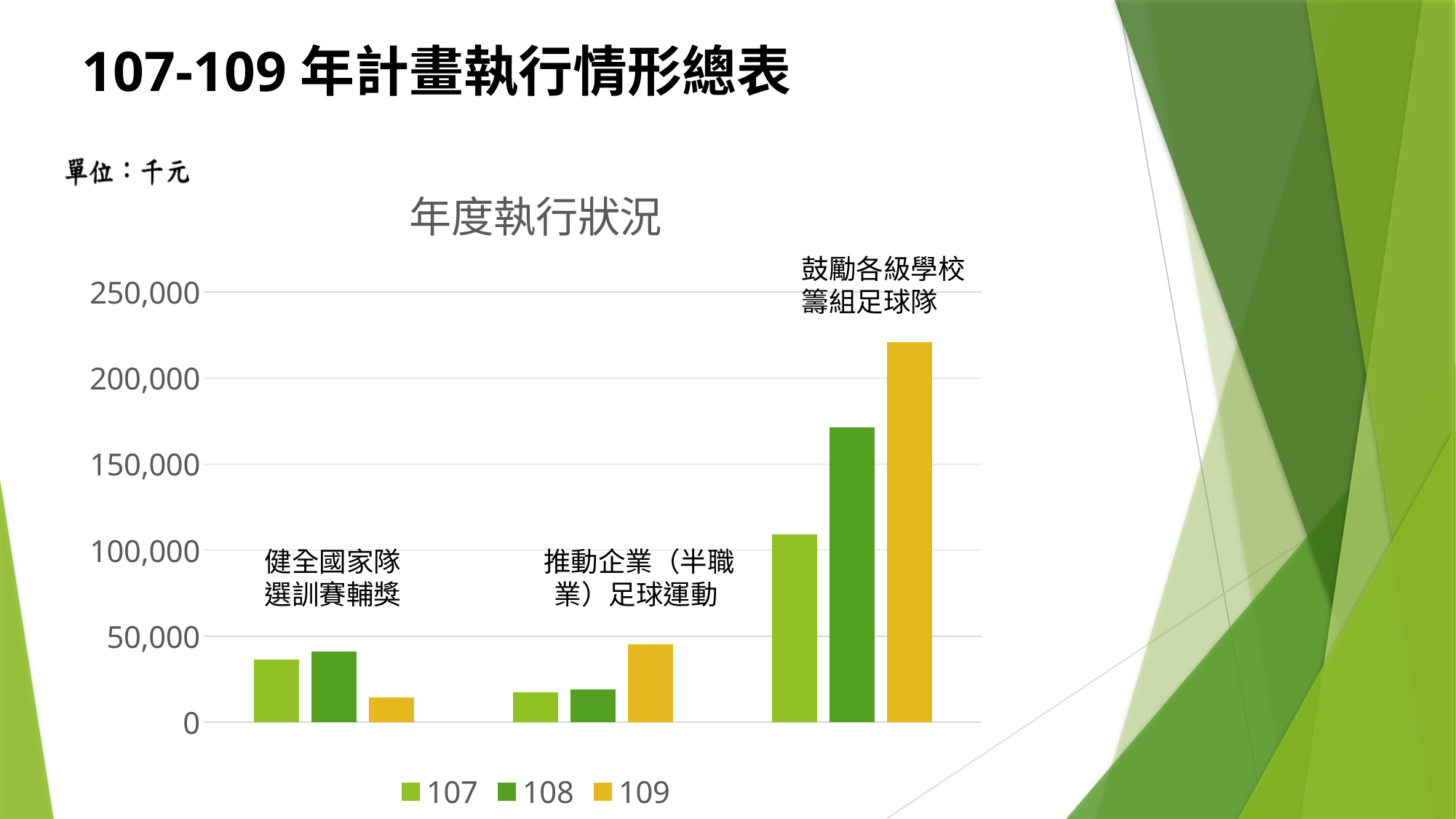
For 鼓勵各級學校籌組足球隊, which series has the larger value, 107 or 109? 109 Is the value for 109 in 健全國家隊選訓賽輔獎 greater or less than 50,000? less Which category has the highest value for series 109? 鼓勵各級學校籌組足球隊 How many categories are plotted on the x axis? 3 Is the value for 107 in 鼓勵各級學校籌組足球隊 greater or less than 100,000? greater How many series does the legend list? 3 What is the title of the chart? 年度執行狀況 Is the value for 108 in 鼓勵各級學校籌組足球隊 greater or less than 150,000? greater For 鼓勵各級學校籌組足球隊, do the values rise or fall from series 107 to 109? rise What kind of chart is shown on the slide? bar chart Which category has the lowest value for series 107? 推動企業（半職業）足球運動